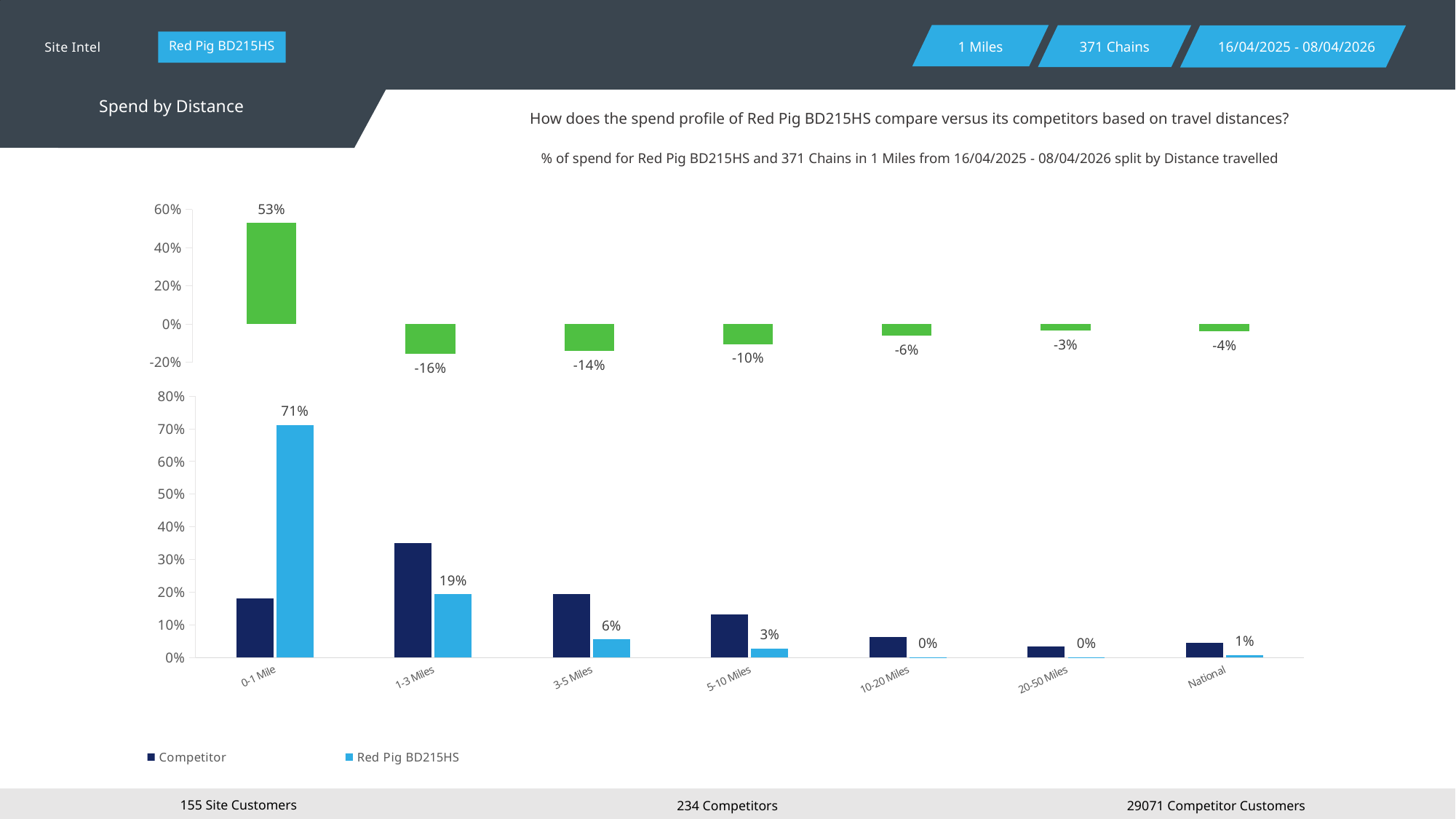
In the bottom chart, is the Competitor value for 0-1 Mile greater or less than 20%? less In the bottom chart, which category has the highest Red Pig BD215HS value? 0-1 Mile In the bottom chart, what is the value for Red Pig BD215HS in the 0-1 Mile category? 71% How many categories are shown on the x axis of the bottom chart? 7 In the bottom chart, what is the difference between the Red Pig BD215HS values for 0-1 Mile and 1-3 Miles? 52% In the bottom chart, is the Competitor value for 1-3 Miles greater or less than 30%? greater In the top chart, what is the value of the first (leftmost) bar? 53% How many series does the legend of the bottom chart list? 2 In the bottom chart, what is the value for Red Pig BD215HS in the 1-3 Miles category? 19% In the bottom chart, which is larger for 1-3 Miles: the Competitor value or the Red Pig BD215HS value? Competitor In the top chart, what is the value of the second bar from the left? -16% In the bottom chart, what is the value for Red Pig BD215HS in the 5-10 Miles category? 3%